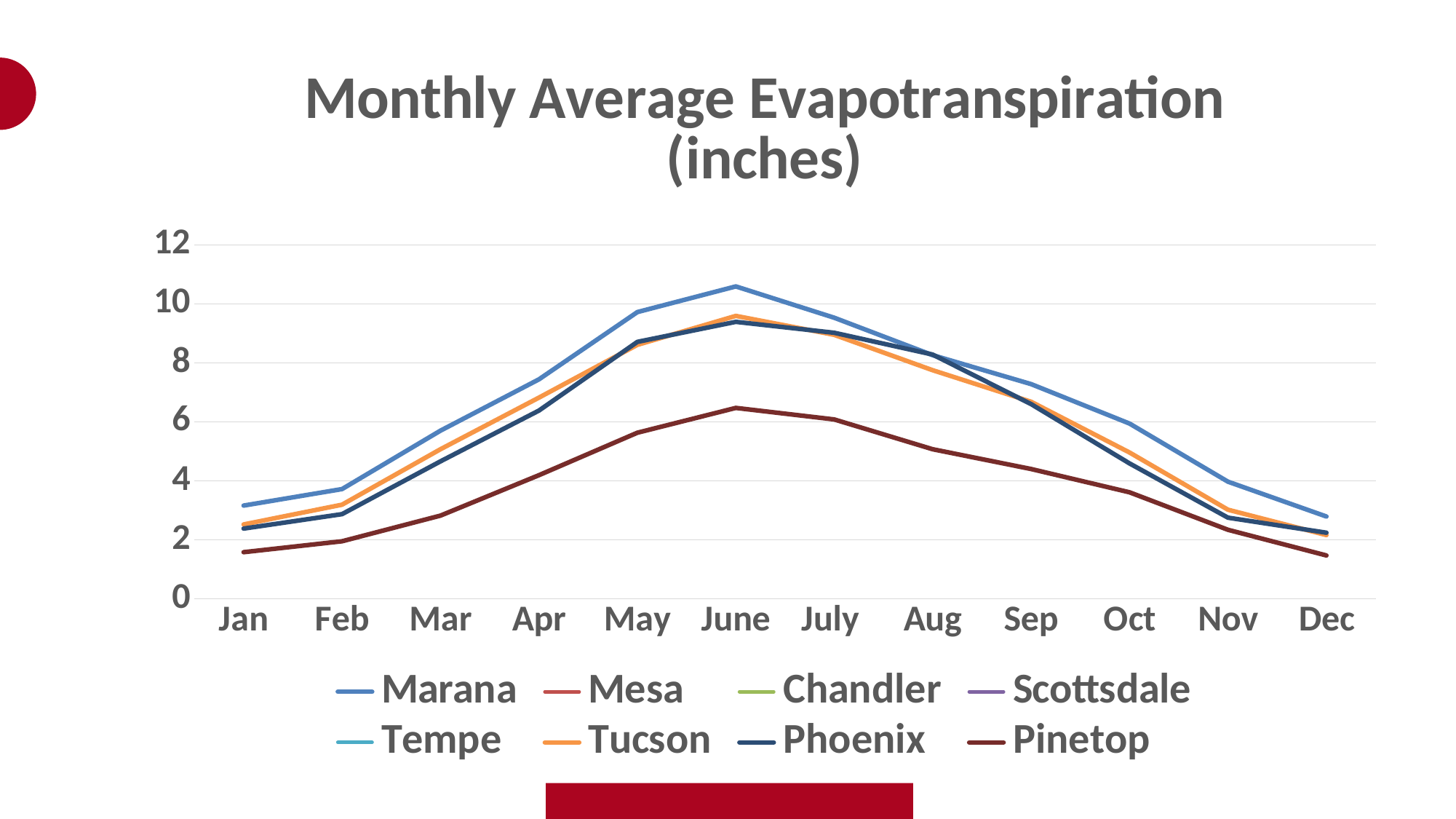
How many series does the legend list? 8 Is the value for Marana in June greater or less than 10? greater What kind of chart is shown on the slide? line chart Is the value for Pinetop in Jan greater or less than 2? less Is the value for Pinetop in June greater or less than 8? less Do the values for Marana rise or fall from Jan to June? rise In which month is the Pinetop line at its lowest value? Dec How many months are plotted along the x axis? 12 In which month does the Marana line reach its highest value? June Which series has the higher value in June, Marana or Pinetop? Marana What is the title of the chart? Monthly Average Evapotranspiration (inches)